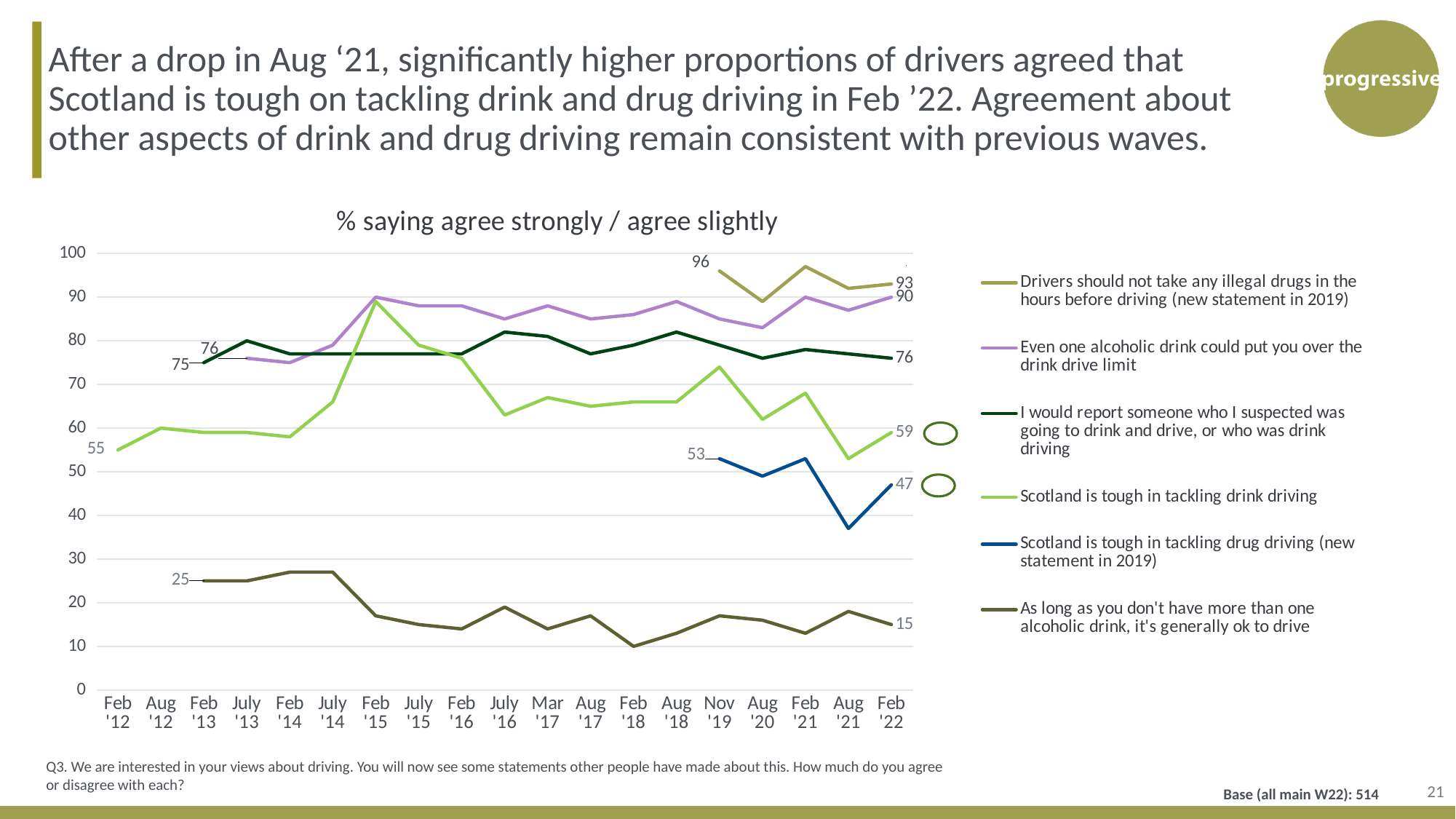
In Feb '22, what is the difference between 'Drivers should not take any illegal drugs in the hours before driving' and 'Scotland is tough in tackling drug driving'? 46 What kind of chart is shown on the slide? line chart Which statement has the lowest agreement in Feb '22? As long as you don't have more than one alcoholic drink, it's generally ok to drive Is the Aug '21 value for 'Scotland is tough in tackling drug driving' greater or less than 50? less How many survey waves are shown along the x axis? 19 What is the Nov '19 value for 'Scotland is tough in tackling drug driving'? 53 How many series does the legend list? 6 What is the Feb '12 value for 'Scotland is tough in tackling drink driving'? 55 What is the Feb '22 value for 'Drivers should not take any illegal drugs in the hours before driving'? 93 In Feb '22, what is the difference between 'Even one alcoholic drink could put you over the drink drive limit' and 'I would report someone who I suspected was going to drink and drive'? 14 Between Aug '21 and Feb '22, does agreement with 'Scotland is tough in tackling drink driving' rise or fall? rise What is the Feb '22 value for 'Scotland is tough in tackling drug driving'? 47